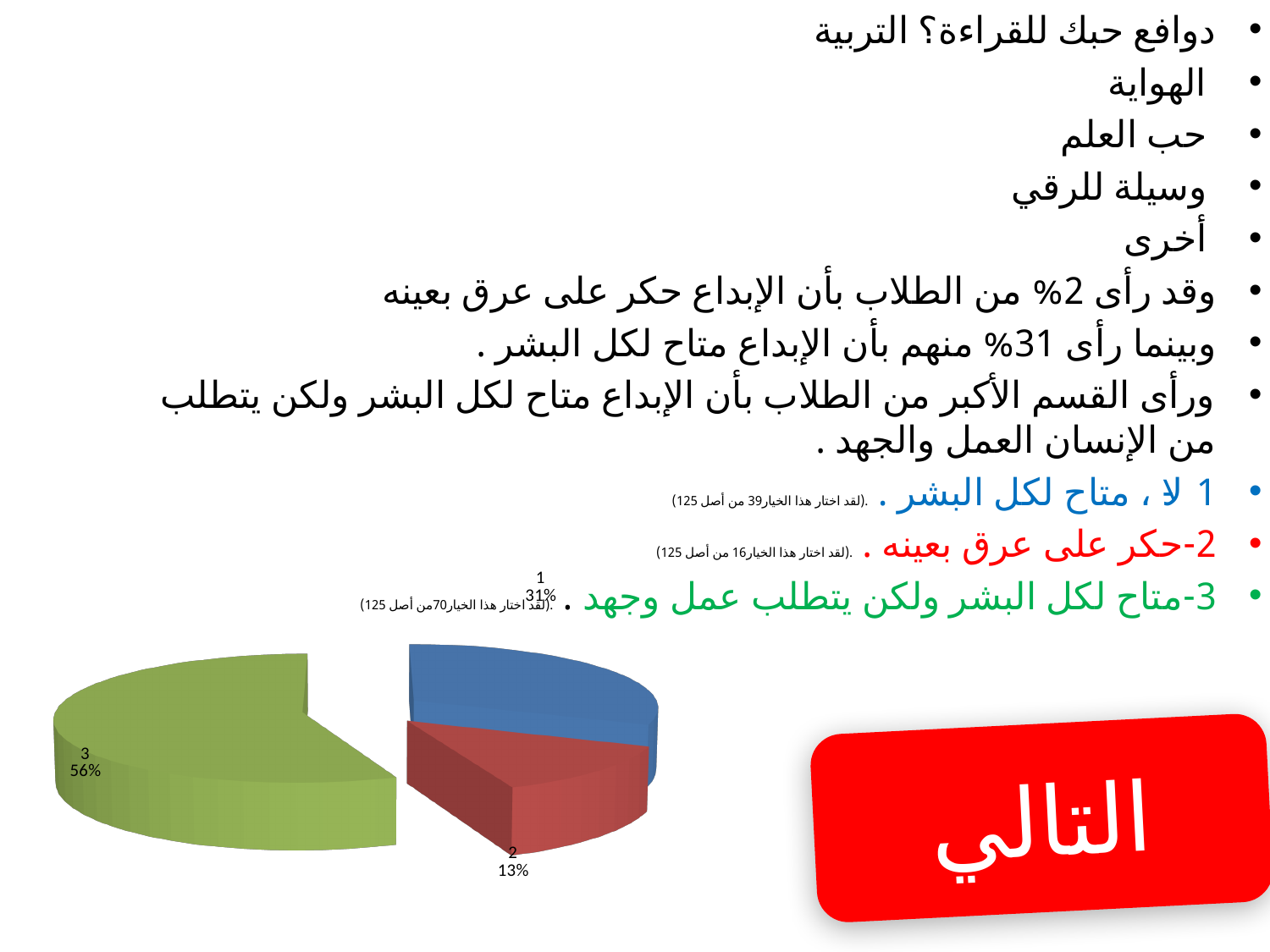
What percentage is shown for slice 3 in the pie chart? 56% What is the difference in percentage points between slice 3 and slice 1 in the pie chart? 25 How many slices does the pie chart have? 3 What percentage is shown for slice 2 in the pie chart? 13% What percentage is shown for slice 1 in the pie chart? 31% What colour is slice 1 in the pie chart? blue What is the difference in percentage points between slice 1 and slice 2 in the pie chart? 18 What kind of chart is shown on the slide? pie chart Which slice of the pie chart is the largest? 3 What colour is slice 3 in the pie chart? green Which slice of the pie chart is the smallest? 2 Which is larger in the pie chart, slice 1 or slice 2? slice 1